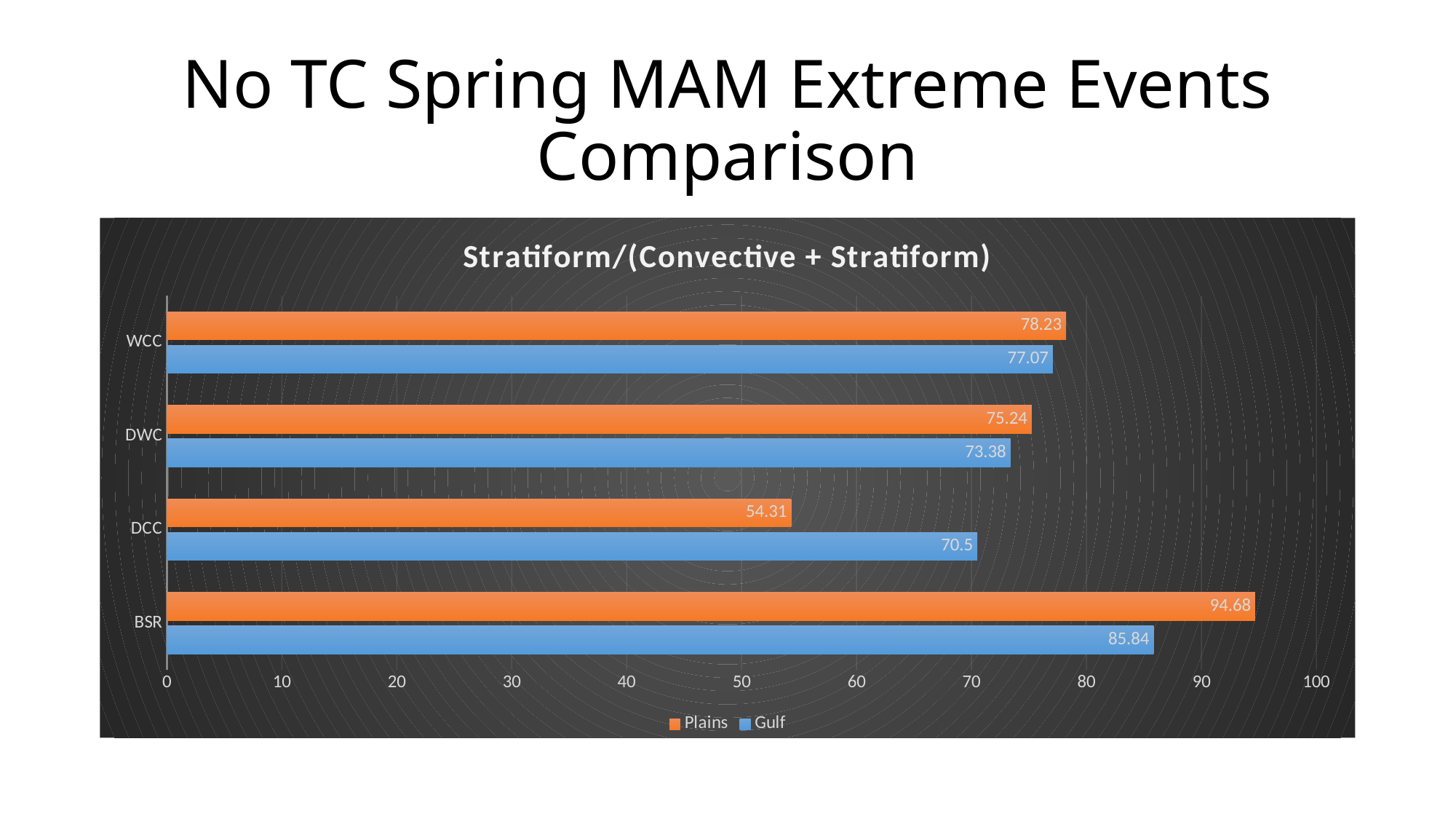
What is the Gulf value for WCC? 77.07 What is the Plains value for BSR? 94.68 What type of chart is shown on the slide? Bar chart Which category has the lowest Plains value? DCC What is the Gulf value for DCC? 70.5 How many categories are shown on the chart? 4 How many series does the legend list? 2 For DCC, which series has the larger value, Plains or Gulf? Gulf What is the difference between the Gulf and Plains values for DCC? 16.19 What is the difference between the Plains and Gulf values for BSR? 8.84 Which category has the highest Plains value? BSR Which category has the lowest Gulf value? DCC